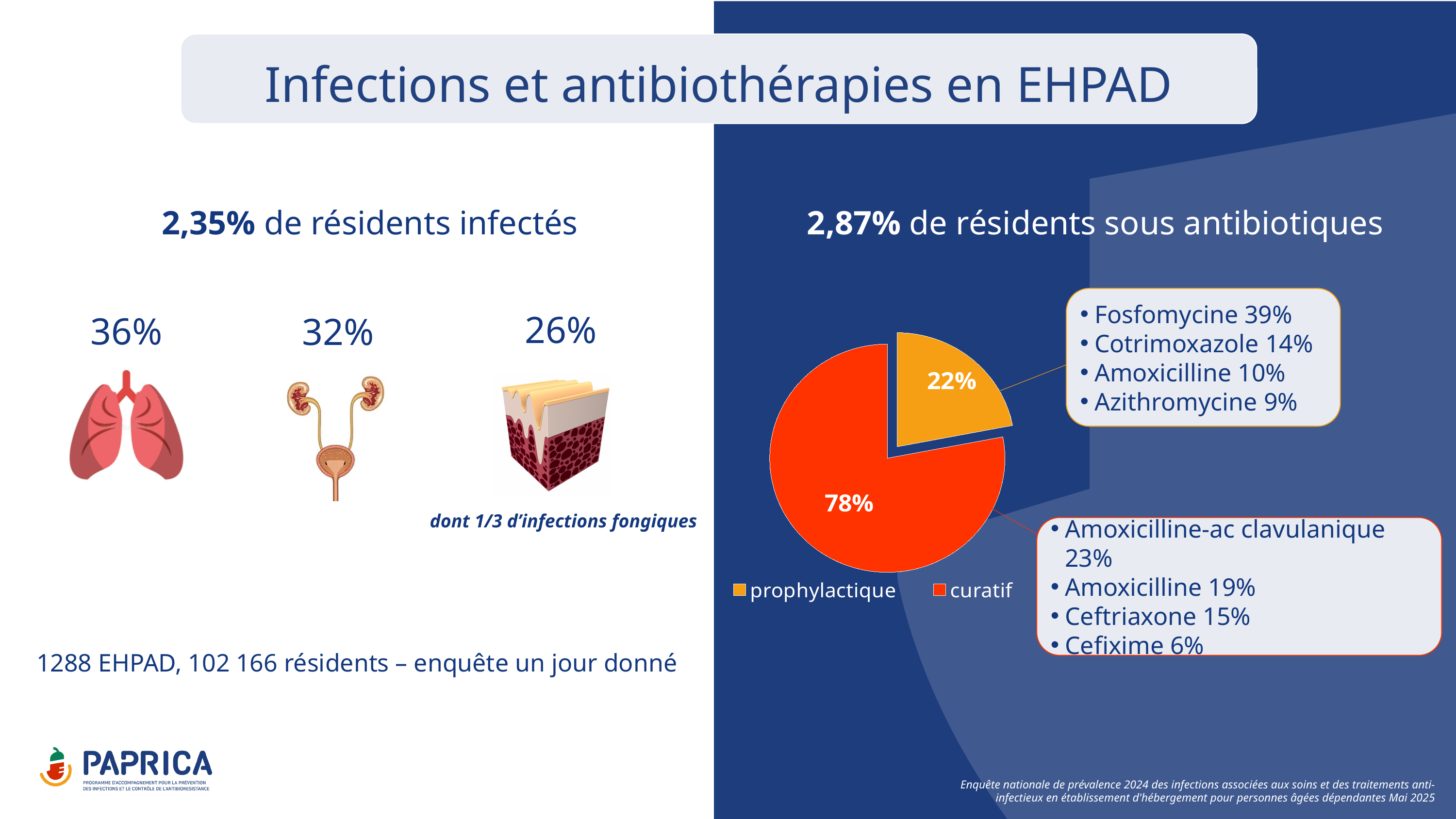
What colour is the curatif slice of the pie chart? red Which is larger in the pie chart, prophylactique or curatif? curatif How many slices does the pie chart have? 2 Which slice of the pie chart is the smallest? prophylactique Which slice of the pie chart is the largest? curatif How many entries does the pie chart legend list? 2 What kind of chart is shown on the slide? pie chart What is the difference in percentage points between the curatif and prophylactique slices? 56 What share of the pie chart is labelled curatif? 78% What colour is the prophylactique slice of the pie chart? orange What share of the pie chart is labelled prophylactique? 22%